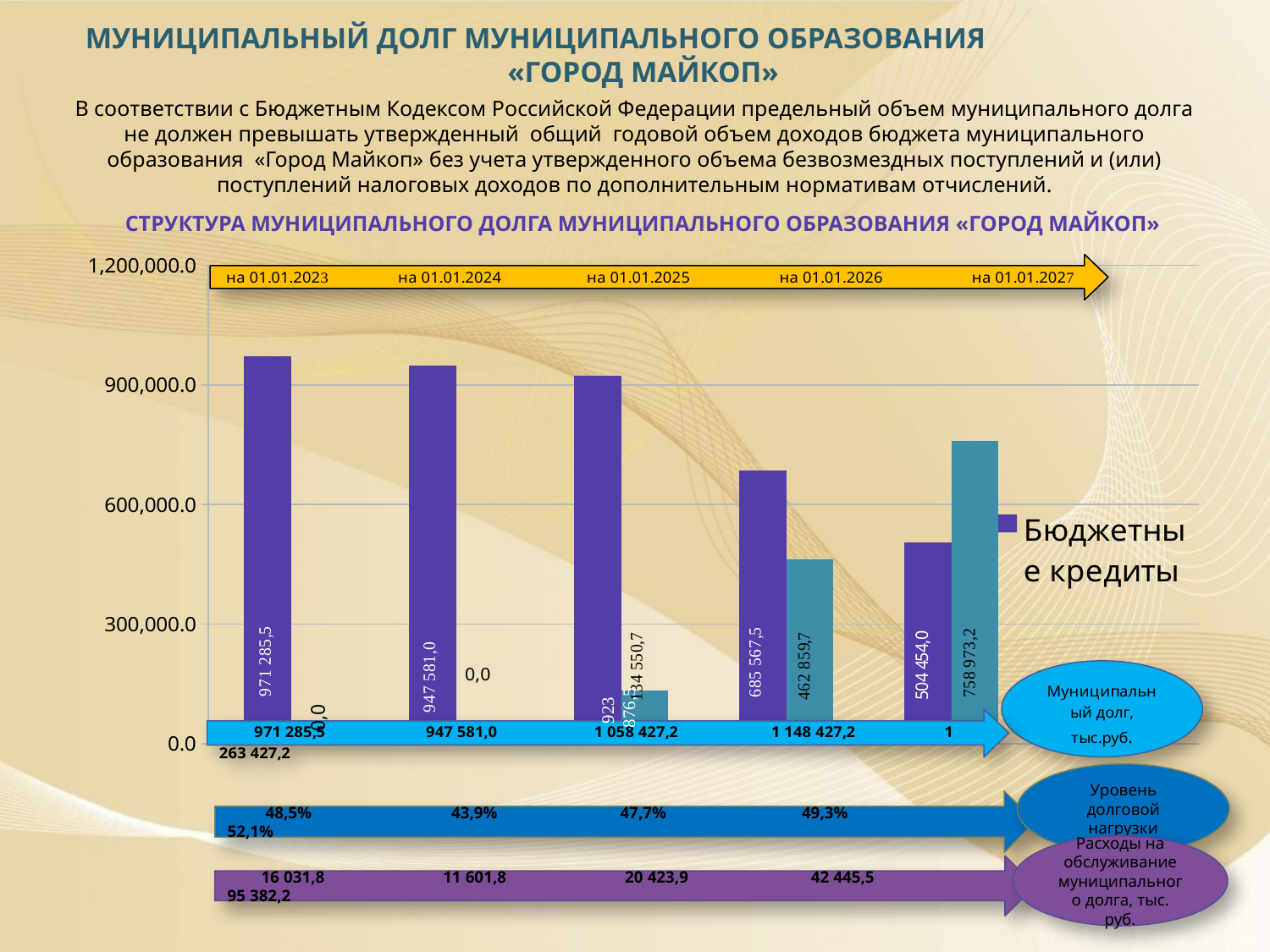
What is the value of Бюджетные кредиты на 01.01.2024? 947 581,0 On which date is the value of Бюджетные кредиты the highest? на 01.01.2023 What is the value of Бюджетные кредиты на 01.01.2027? 504 454,0 On which date is the value of Бюджетные кредиты the lowest? на 01.01.2027 Is the value of Бюджетные кредиты на 01.01.2027 greater or less than 600,000.0? less Which is larger: Бюджетные кредиты на 01.01.2026 or на 01.01.2027? на 01.01.2026 What is the difference between Бюджетные кредиты на 01.01.2023 and на 01.01.2024? 23 704,5 Do the values of Бюджетные кредиты rise or fall from 01.01.2023 to 01.01.2027? fall What kind of chart is shown on the slide? bar chart What is the value of Бюджетные кредиты на 01.01.2026? 685 567,5 How many dates (categories) are shown on the x axis of the chart? 5 What is the value of Бюджетные кредиты на 01.01.2023? 971 285,5